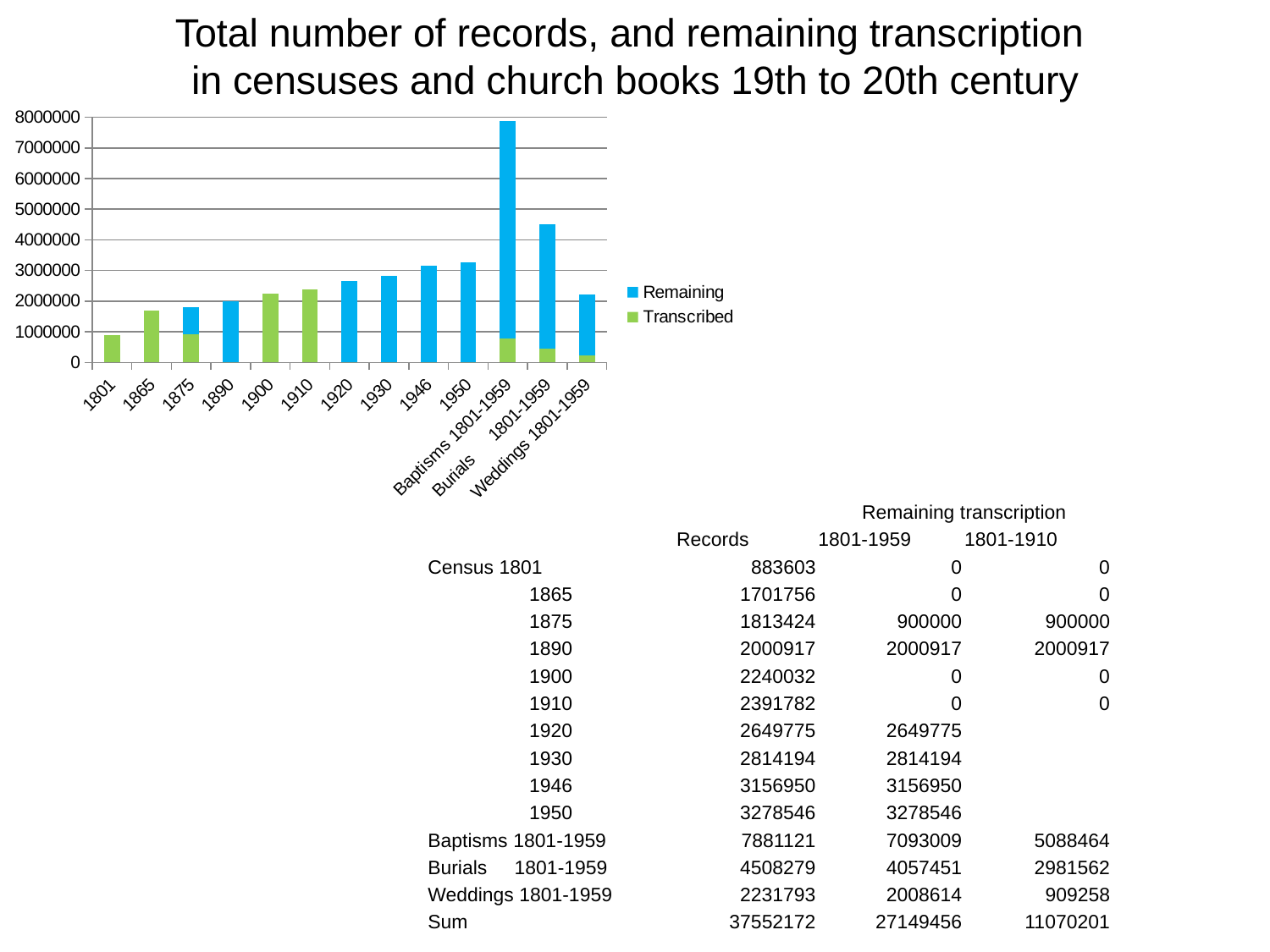
How many categories are shown along the x axis of the chart? 13 How many series does the chart's legend list? 2 Which colour represents the Transcribed series in the chart? green Is the total bar height for Burials 1801-1959 greater or less than 4000000? greater Which category has the shortest bar in the chart? 1801 Is the total bar height for 1801 greater or less than 1000000? less Is the total bar height for Baptisms 1801-1959 greater or less than 7000000? greater What kind of chart is shown on the slide? bar chart Which bar is taller, Burials 1801-1959 or Weddings 1801-1959? Burials 1801-1959 Do the census bars rise or fall from 1801 to 1950 along the x axis? rise Which category has the tallest bar in the chart? Baptisms 1801-1959